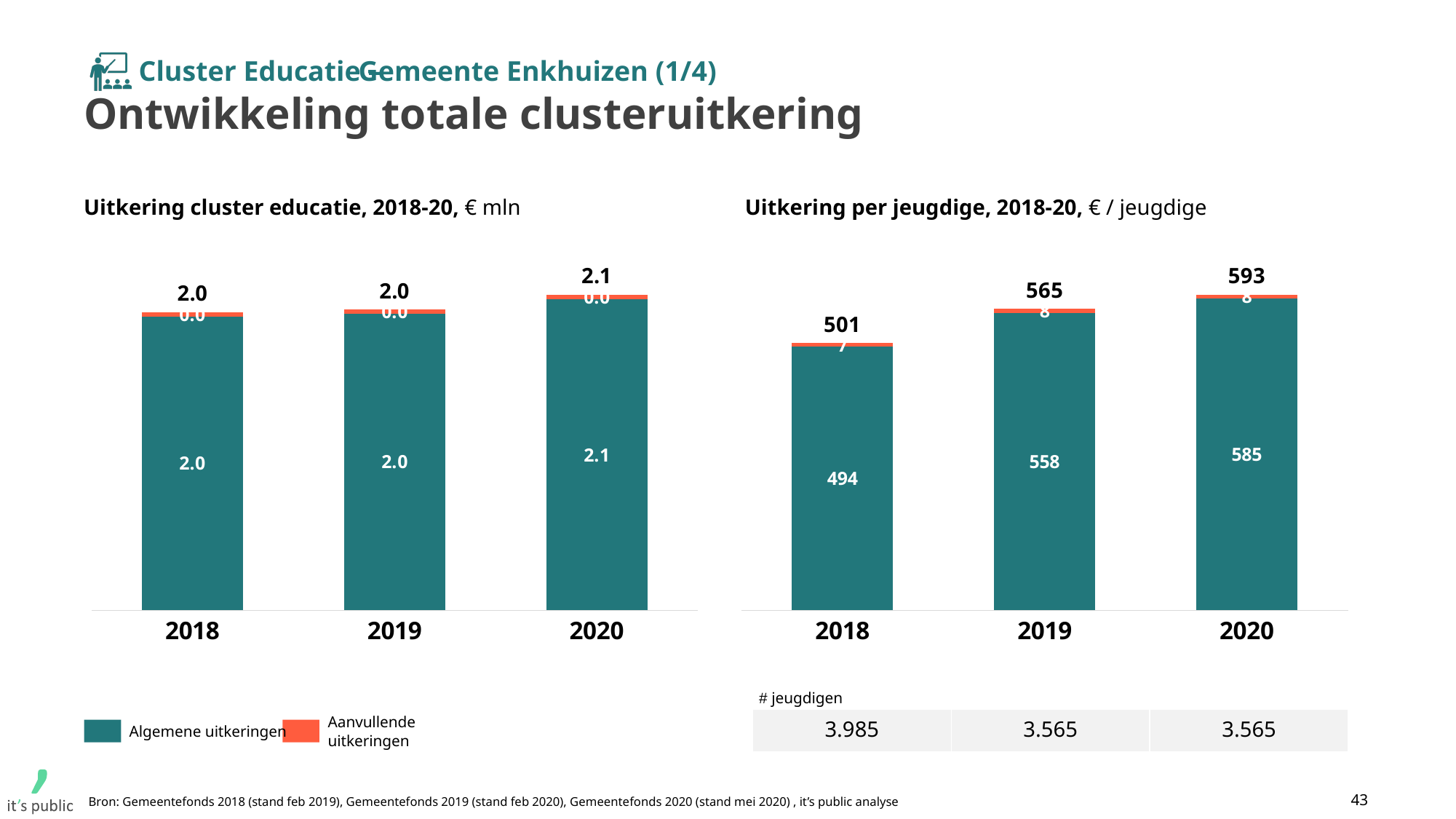
In the chart 'Uitkering per jeugdige, 2018-20', what is the total value for 2018? 501 In the chart 'Uitkering cluster educatie, 2018-20', what is the total value for 2020? 2.1 How many years are shown on the x axis of the chart 'Uitkering cluster educatie, 2018-20'? 3 What kind of chart is 'Uitkering per jeugdige, 2018-20'? Stacked bar chart In the chart 'Uitkering per jeugdige, 2018-20', which year has the lowest total value? 2018 In the chart 'Uitkering per jeugdige, 2018-20', which year has the highest total value? 2020 In the chart 'Uitkering cluster educatie, 2018-20', what is the Algemene uitkeringen value for 2018? 2.0 In the chart 'Uitkering per jeugdige, 2018-20', what is the Aanvullende uitkeringen value for 2020? 8 In the chart 'Uitkering per jeugdige, 2018-20', what is the difference between the total values for 2020 and 2018? 92 In the chart 'Uitkering per jeugdige, 2018-20', is the Algemene uitkeringen value larger in 2019 or in 2020? 2020 In the chart 'Uitkering per jeugdige, 2018-20', what is the Algemene uitkeringen value for 2019? 558 How many series does the legend on the slide list? 2